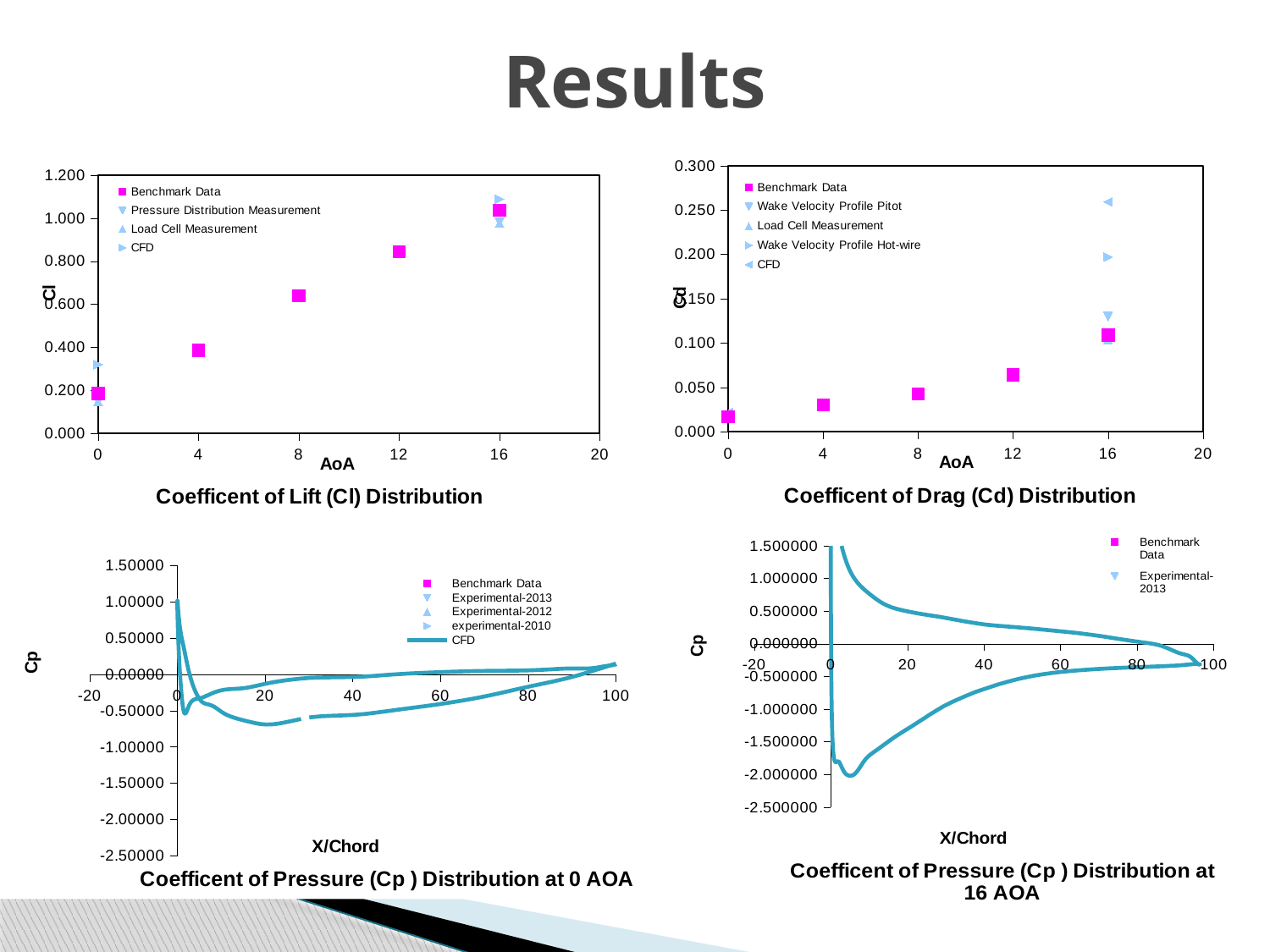
In the Coefficent of Lift (Cl) Distribution chart, do the Benchmark Data values rise or fall as AoA increases? rise In the Coefficent of Drag (Cd) Distribution chart, at which AoA is the Benchmark Data value highest? 16 In the Coefficent of Pressure (Cp) Distribution at 16 AOA chart, how many series does the legend list? 2 In the Coefficent of Lift (Cl) Distribution chart, how many series does the legend list? 4 What is the x-axis label of the Coefficent of Pressure (Cp) Distribution at 0 AOA chart? X/Chord In the Coefficent of Drag (Cd) Distribution chart, is the CFD value at AoA 16 greater or less than 0.250? greater In the Coefficent of Drag (Cd) Distribution chart, which is larger at AoA 16: the CFD value or the Benchmark Data value? CFD How many charts are shown on the slide? 4 In the Coefficent of Lift (Cl) Distribution chart, is the Benchmark Data value at AoA 12 greater or less than 0.800? greater In the Coefficent of Lift (Cl) Distribution chart, how many Benchmark Data points are plotted? 5 In the Coefficent of Drag (Cd) Distribution chart, how many series does the legend list? 5 In the Coefficent of Lift (Cl) Distribution chart, is the Benchmark Data value at AoA 16 greater or less than 1.000? greater